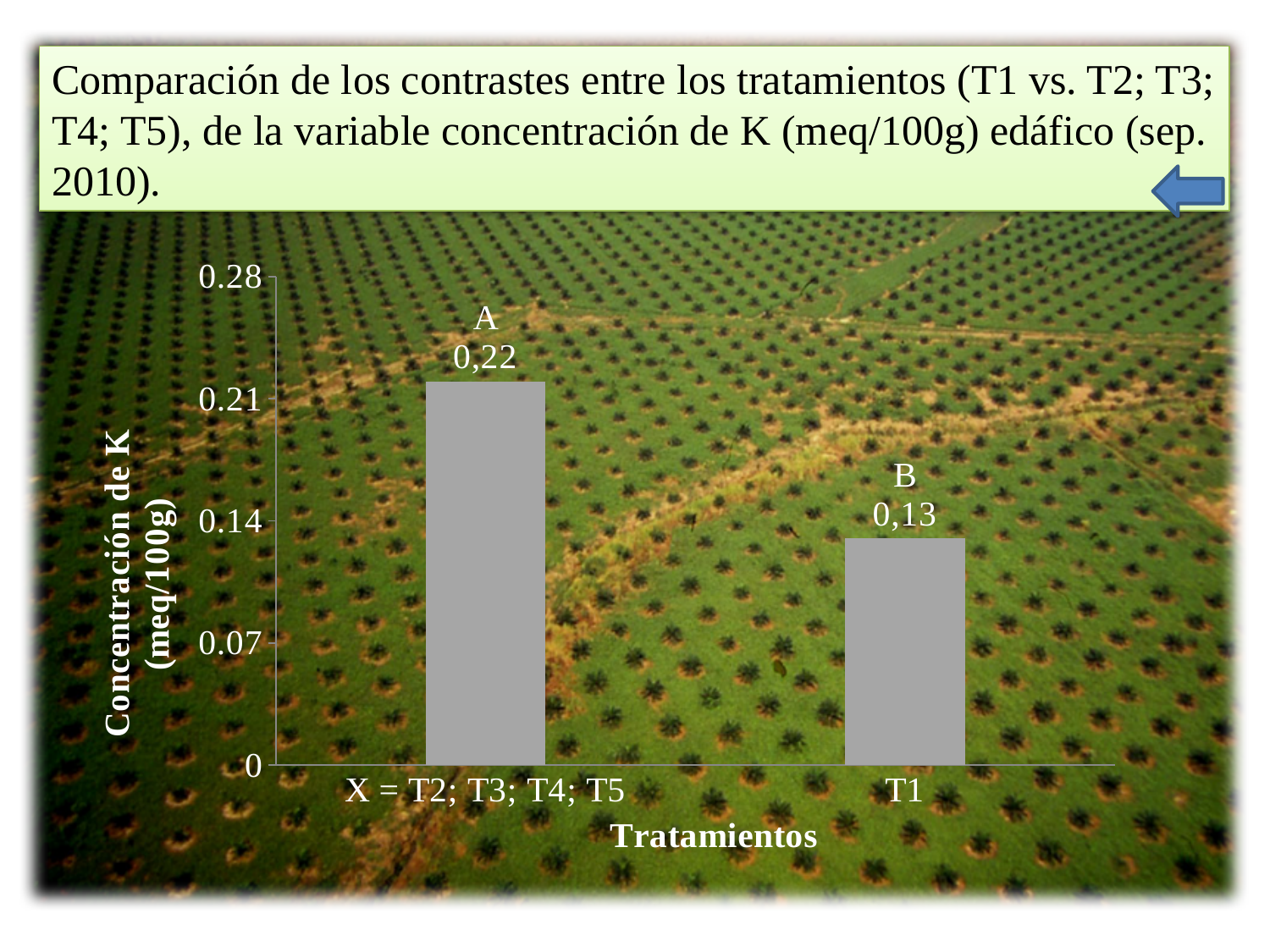
What kind of chart is shown on the slide? bar chart Is the value for "X = T2; T3; T4; T5" greater or less than 0.21? greater What letter is printed above the bar for T1? B How many bars are plotted in the chart? 2 What is the title of the vertical axis of the chart? Concentración de K (meq/100g) What is the K concentration value shown for treatment T1? 0,13 Which is larger, the K concentration for T1 or for "X = T2; T3; T4; T5"? X = T2; T3; T4; T5 What is the difference between the K concentration for "X = T2; T3; T4; T5" and for T1? 0,09 Which category has the highest K concentration? X = T2; T3; T4; T5 Which category has the lowest K concentration? T1 Is the value for T1 greater or less than 0.14? less What is the K concentration value shown for the bar labelled "X = T2; T3; T4; T5"? 0,22